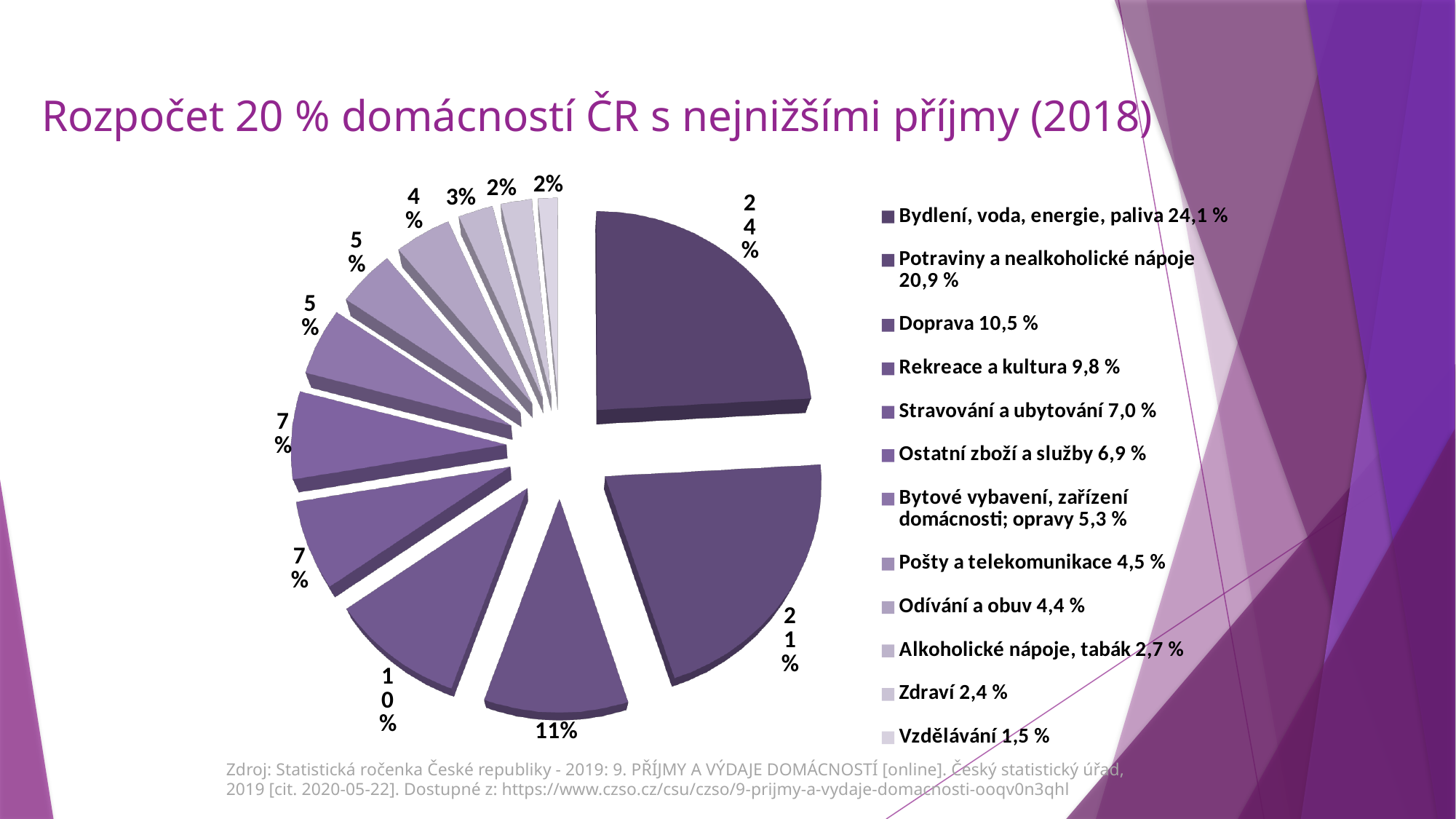
What kind of chart is shown on the slide? Pie chart Which is larger, the share for Doprava or the share for Rekreace a kultura? Doprava According to the legend, what share of the budget goes to Bydlení, voda, energie, paliva? 24,1 % How many categories (slices) does the pie chart have? 12 Using the legend values, what is the difference between Bydlení, voda, energie, paliva and Potraviny a nealkoholické nápoje? 3,2 percentage points Which category has the largest share of the pie? Bydlení, voda, energie, paliva According to the legend, what is the value for Zdraví? 2,4 % According to the legend, what share of the budget goes to Potraviny a nealkoholické nápoje? 20,9 % According to the legend, what is the value for Doprava? 10,5 % Which category has the smallest share of the pie? Vzdělávání What rounded percentage is printed as the data label on the Potraviny a nealkoholické nápoje slice? 21% What is the title of the slide containing the chart? Rozpočet 20 % domácností ČR s nejnižšími příjmy (2018)